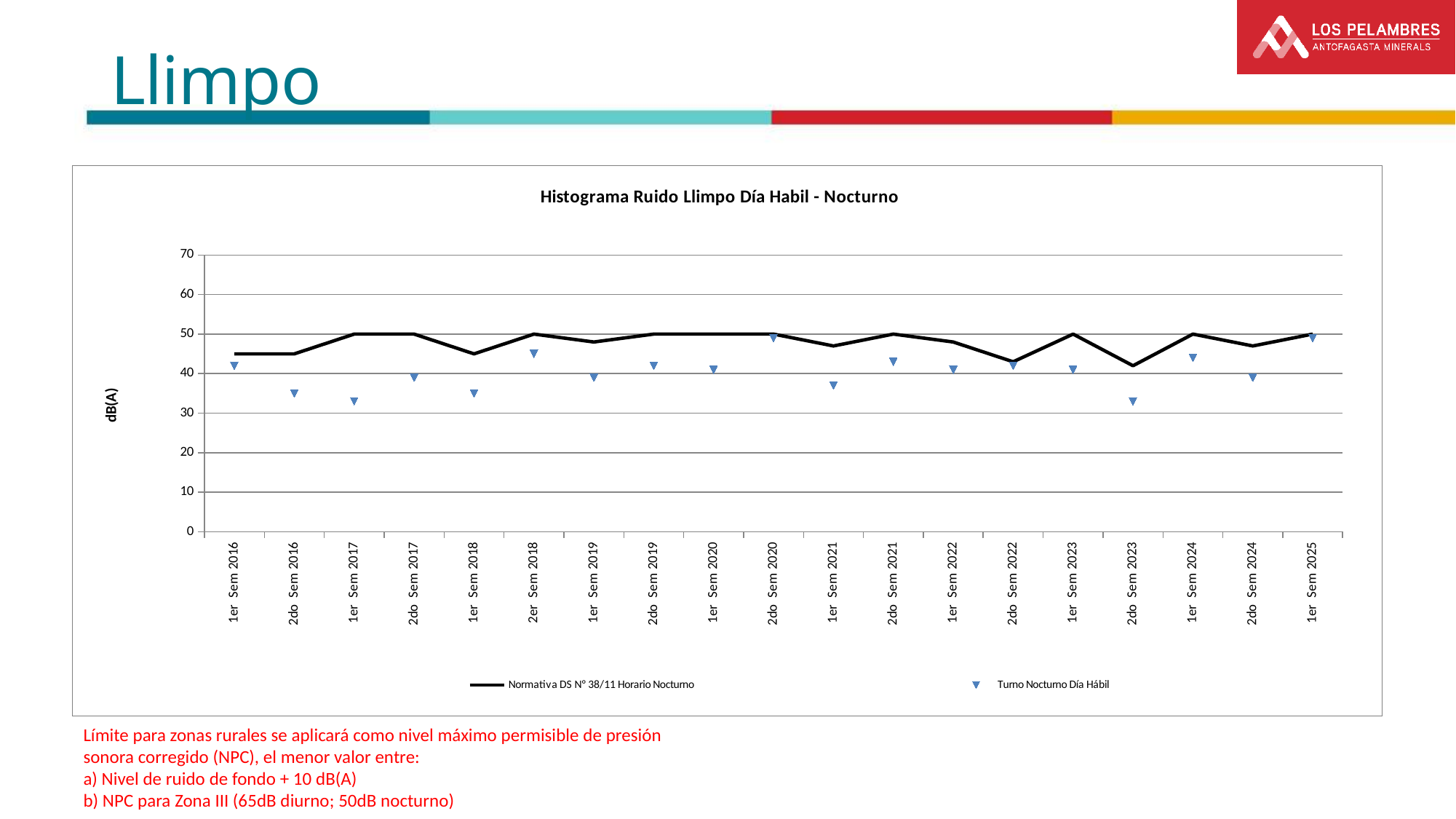
How many semester categories are shown on the x axis? 19 Is the Turno Nocturno Día Hábil value for 1er Sem 2021 greater or less than 40? less How many series does the legend list? 2 What is the title of the chart? Histograma Ruido Llimpo Día Habil - Nocturno Is the Turno Nocturno Día Hábil value for 1er Sem 2024 greater or less than 40? greater What is the value of the Normativa DS N° 38/11 Horario Nocturno line at 1er Sem 2017? 50 What is the label of the y axis? dB(A) What kind of chart is shown on the slide? line chart Is the Turno Nocturno Día Hábil value for 2er Sem 2018 greater or less than 40? greater Which is larger, the Turno Nocturno Día Hábil value for 2er Sem 2018 or for 1er Sem 2017? 2er Sem 2018 Which is larger, the Turno Nocturno Día Hábil value for 2do Sem 2020 or for 2do Sem 2023? 2do Sem 2020